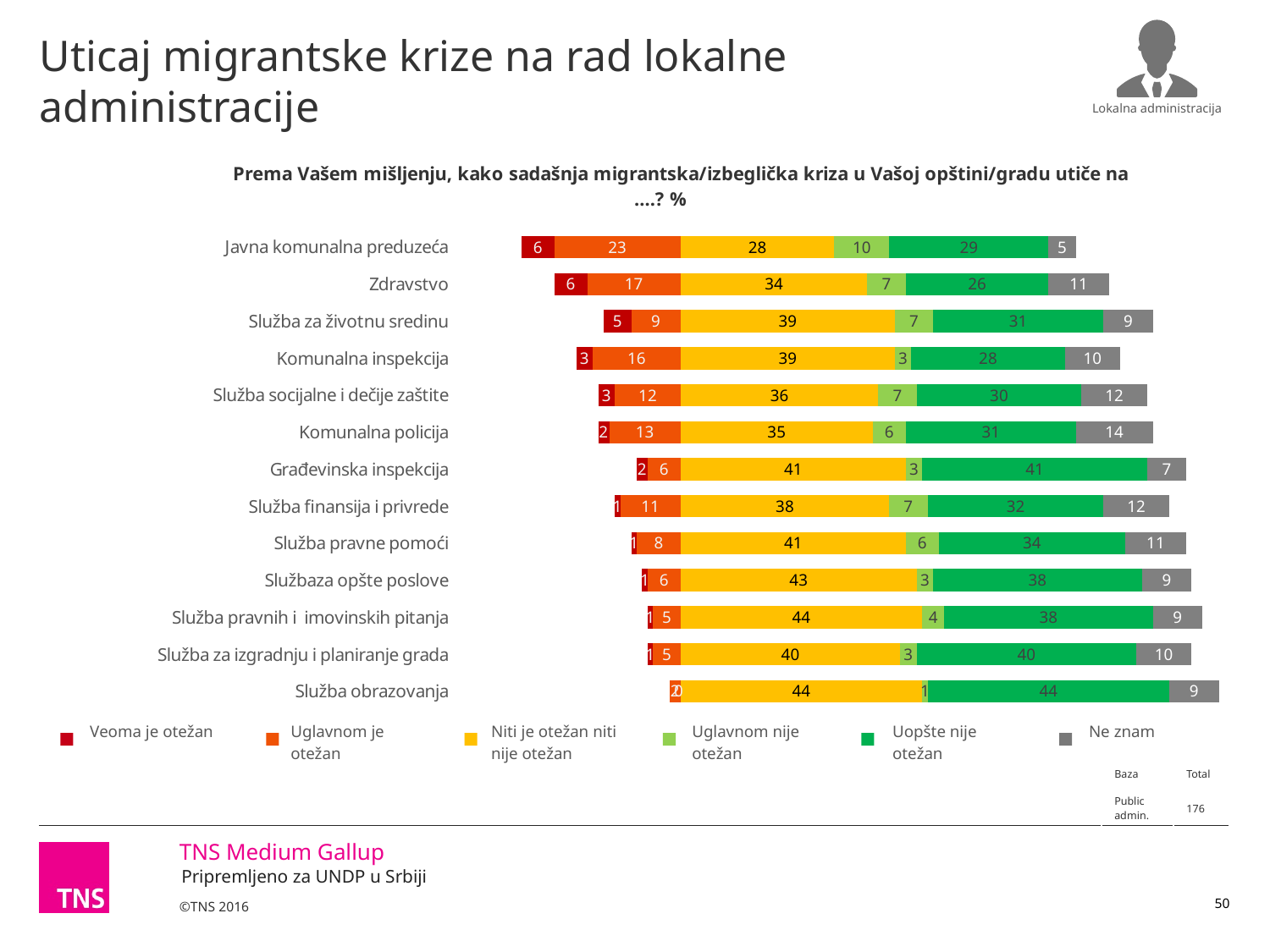
What is the 'Niti je otežan niti nije otežan' value for Zdravstvo? 34 For Zdravstvo, what is the difference between the 'Niti je otežan niti nije otežan' value and the 'Uglavnom je otežan' value? 17 How many series does the legend list? 6 What is the base (Baza) total for Public admin. shown on the slide? 176 Which category has the lowest 'Ne znam' value? Javna komunalna preduzeća Which is larger for Komunalna inspekcija: the 'Niti je otežan niti nije otežan' value or the 'Uopšte nije otežan' value? Niti je otežan niti nije otežan What is the 'Ne znam' value for Komunalna policija? 14 Which category has the highest 'Uglavnom je otežan' value? Javna komunalna preduzeća What percentage of respondents said the work of Javna komunalna preduzeća is 'Uglavnom je otežan'? 23 What kind of chart is shown on the slide? Stacked bar chart How many categories (services) are shown in the chart? 13 What is the 'Uopšte nije otežan' value for Služba pravnih i imovinskih pitanja? 38